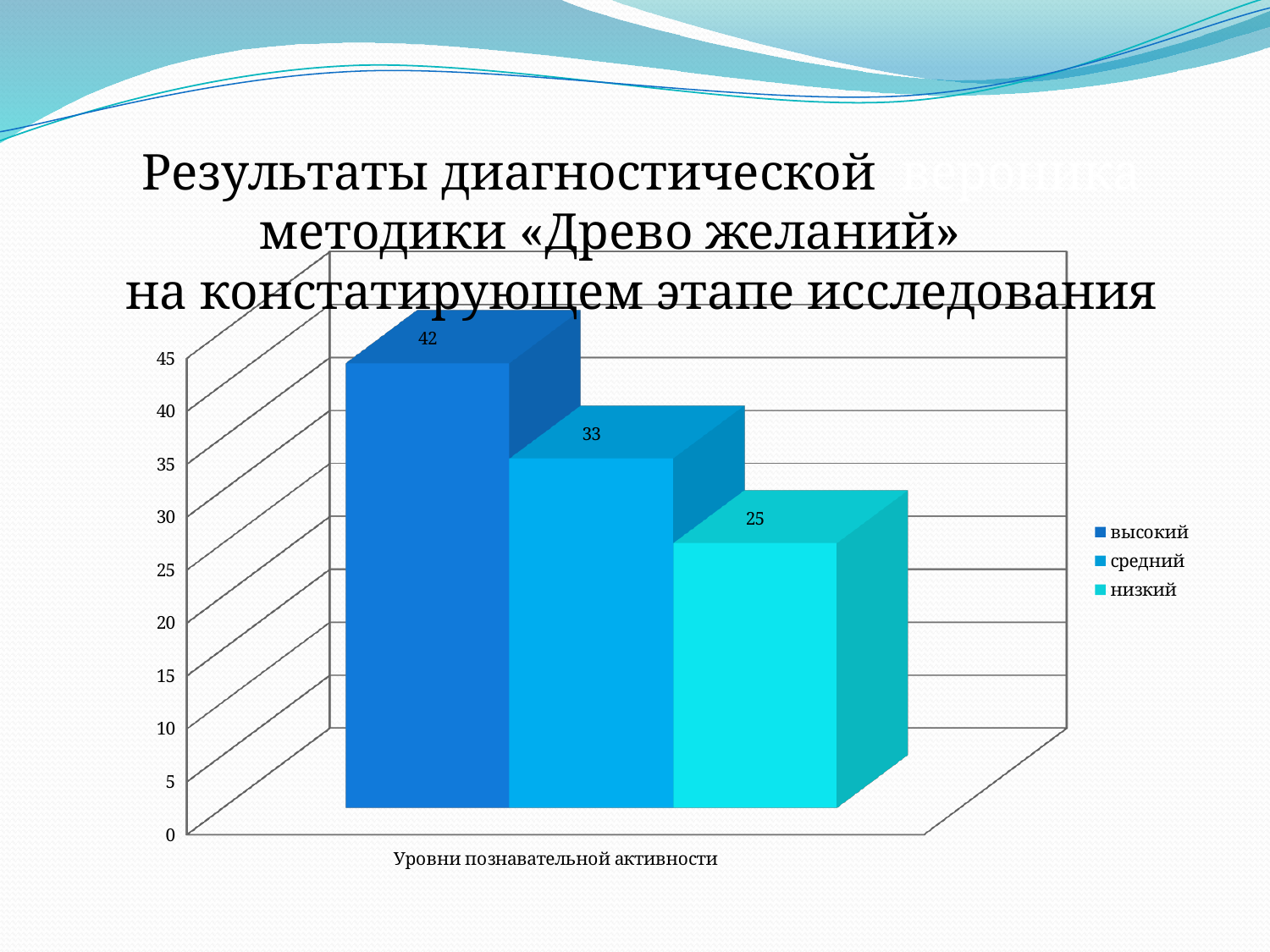
Which series has the lowest value? низкий What is the value for the series "высокий"? 42 What is the difference between the values for "средний" and "низкий"? 8 What is the value for the series "низкий"? 25 What is the difference between the values for "высокий" and "средний"? 9 What is the value for the series "средний"? 33 What is the label on the horizontal axis of the chart? Уровни познавательной активности What kind of chart is shown on the slide? bar chart Which is larger, the value for "средний" or the value for "низкий"? средний Is the value for "высокий" greater or less than 40? greater How many series does the legend list? 3 Which series has the highest value? высокий